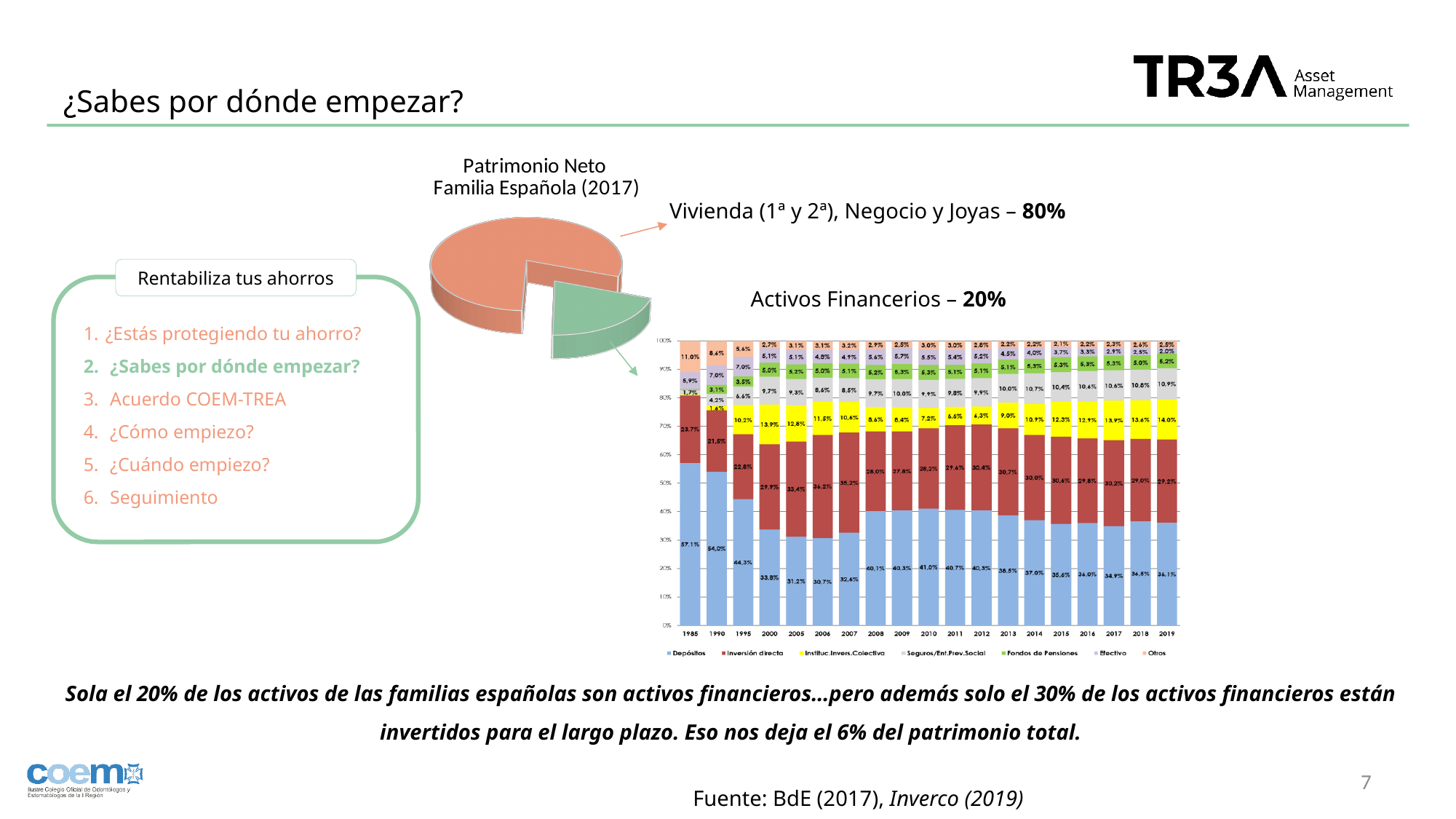
In the stacked bar chart on the right, what is the value for Inversión directa in 2006? 36.2% In the stacked bar chart on the right, which year has the highest value for Depósitos? 1985 In the stacked bar chart on the right, what is the value for Depósitos in 1985? 57.1% In the stacked bar chart on the right, does the Depósitos share rise or fall from 1985 to 2000? Fall In the stacked bar chart on the right, what is the difference between the Depósitos value in 1985 and in 2019? 21.0 percentage points In the pie chart 'Patrimonio Neto Familia Española (2017)', what share is Vivienda (1ª y 2ª), Negocio y Joyas? 80% How many series does the legend of the stacked bar chart on the right list? 7 How many years are shown on the x axis of the stacked bar chart on the right? 19 In the stacked bar chart on the right, what is the value for Depósitos in 2019? 36.1% What kind of chart is the 'Patrimonio Neto Familia Española (2017)' chart? Pie chart In the pie chart 'Patrimonio Neto Familia Española (2017)', what share is Activos Financieros? 20% In the stacked bar chart on the right, which is larger in 2019: Depósitos or Inversión directa? Depósitos